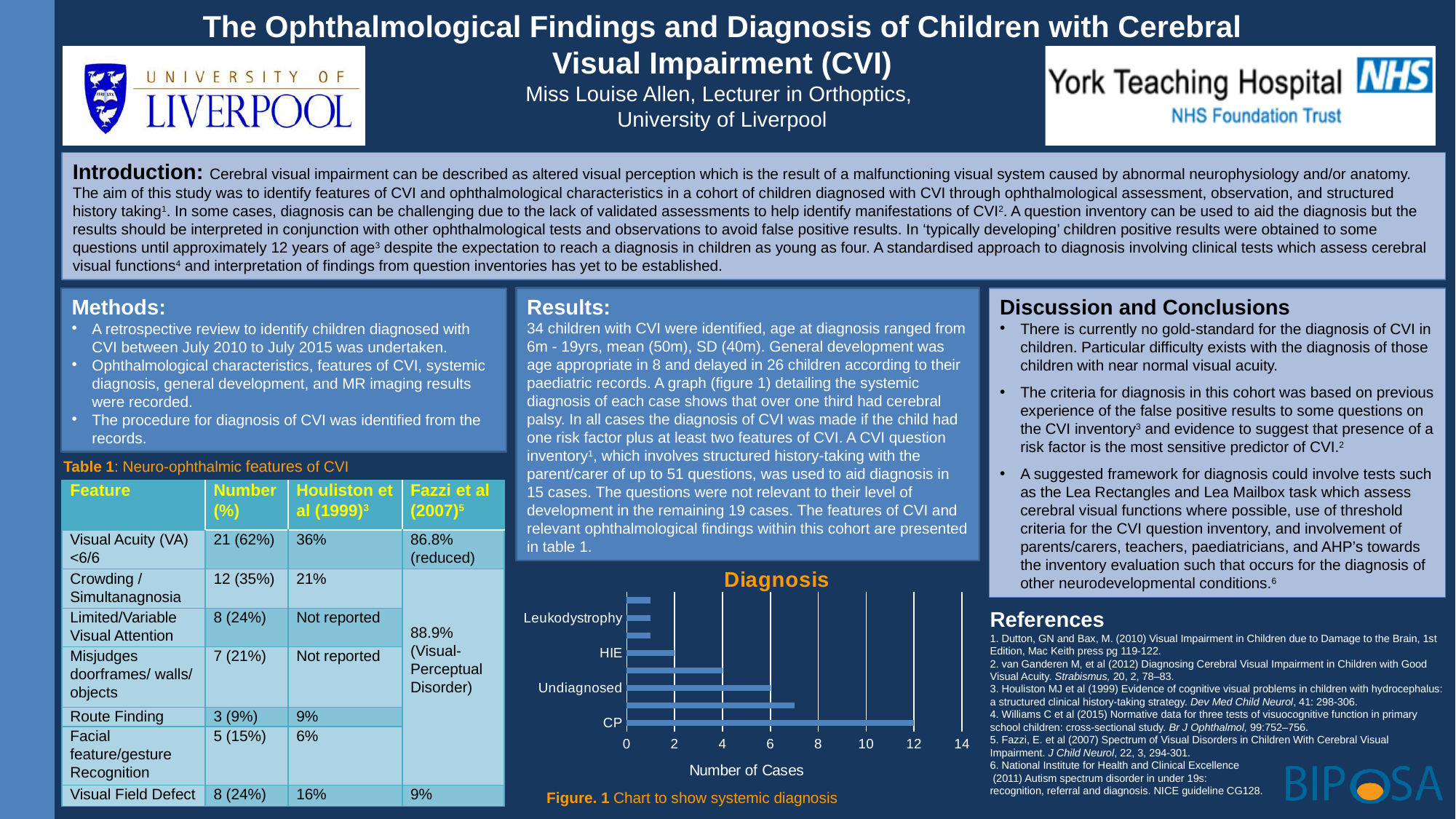
In the "Diagnosis" chart, of Leukodystrophy, HIE, Undiagnosed and CP, which has the fewest cases? Leukodystrophy In the "Diagnosis" chart, is the value for CP greater or less than 10? greater What is the title of the chart in Figure 1? Diagnosis In the "Diagnosis" chart, which category has the highest number of cases? CP In the "Diagnosis" chart, which has more cases, CP or Undiagnosed? CP In the "Diagnosis" chart, is the value for Leukodystrophy greater or less than 2? less What kind of chart is the "Diagnosis" chart? bar chart In the "Diagnosis" chart, is the value for Undiagnosed greater or less than 4? greater In the "Diagnosis" chart, which has more cases, HIE or Leukodystrophy? HIE What is the label on the horizontal axis of the "Diagnosis" chart? Number of Cases How many bars are plotted in the "Diagnosis" chart? 8